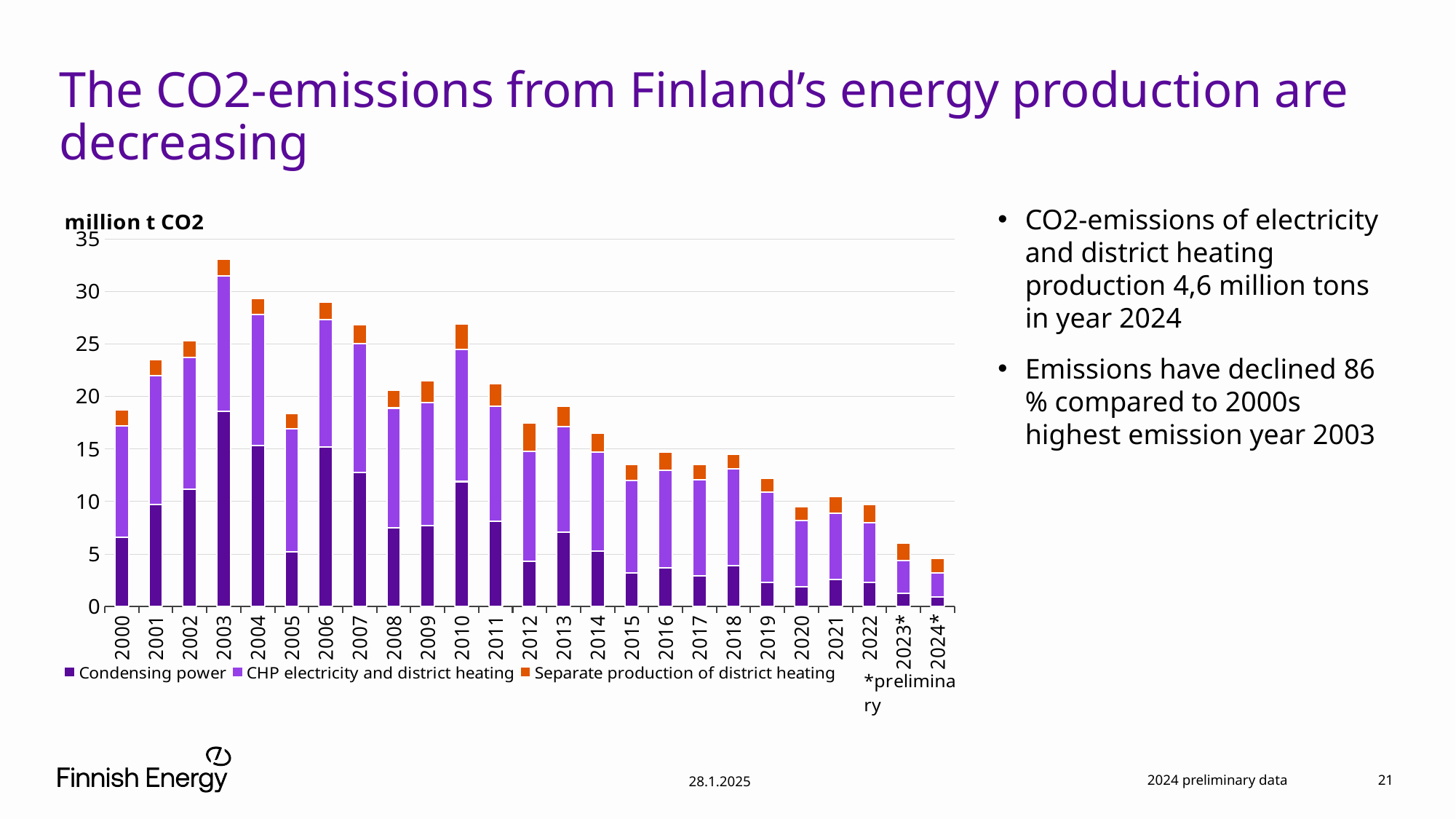
Do the total emissions generally rise or fall from 2003 to 2024*? fall Which year has a larger total, 2005 or 2006? 2006 How many series does the chart's legend list? 3 Is the total value for 2005 greater or less than 20? less What unit is given for the y axis of the chart? million t CO2 Which year has the highest total CO2 emissions in the chart? 2003 Is the total value for 2003 greater or less than 30? greater Which year has a larger total, 2010 or 2011? 2010 What kind of chart is shown on the slide? bar chart Which year has the lowest total CO2 emissions in the chart? 2024* How many years are shown along the x axis of the chart? 25 Is the total value for 2024* greater or less than 5? less